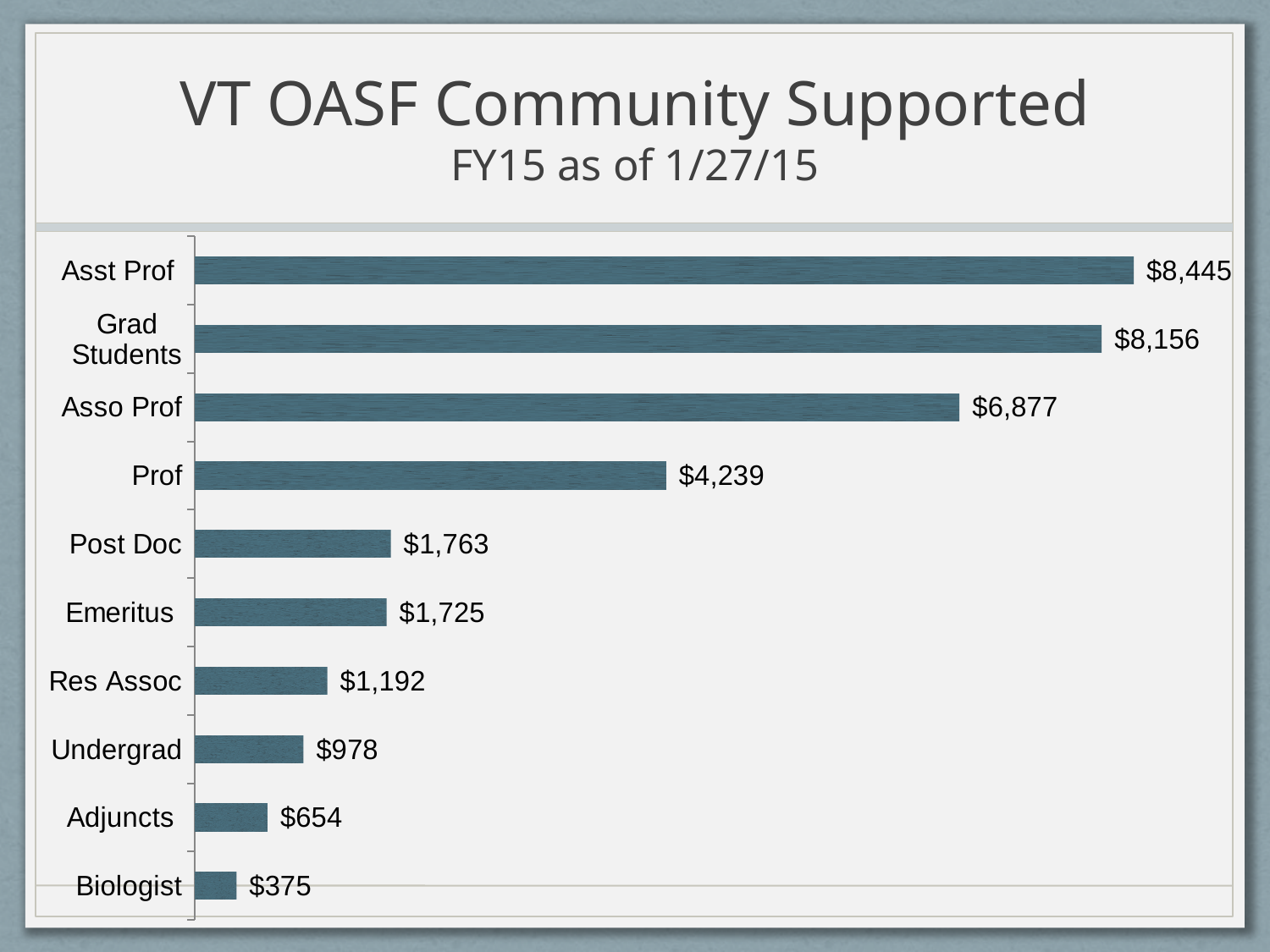
What is the value for Biologist? $375 What is the value for Post Doc? $1,763 What is the title of the chart on the slide? VT OASF Community Supported FY15 as of 1/27/15 Which category has the highest value? Asst Prof What kind of chart is shown on the slide? Bar chart What is the value for Grad Students? $8,156 What is the difference between the values for Undergrad and Adjuncts? $324 What is the value for Asst Prof? $8,445 How many categories are shown in the chart? 10 Which is larger, the value for Res Assoc or the value for Emeritus? Emeritus What is the difference between the values for Asso Prof and Prof? $2,638 Which category has the lowest value? Biologist